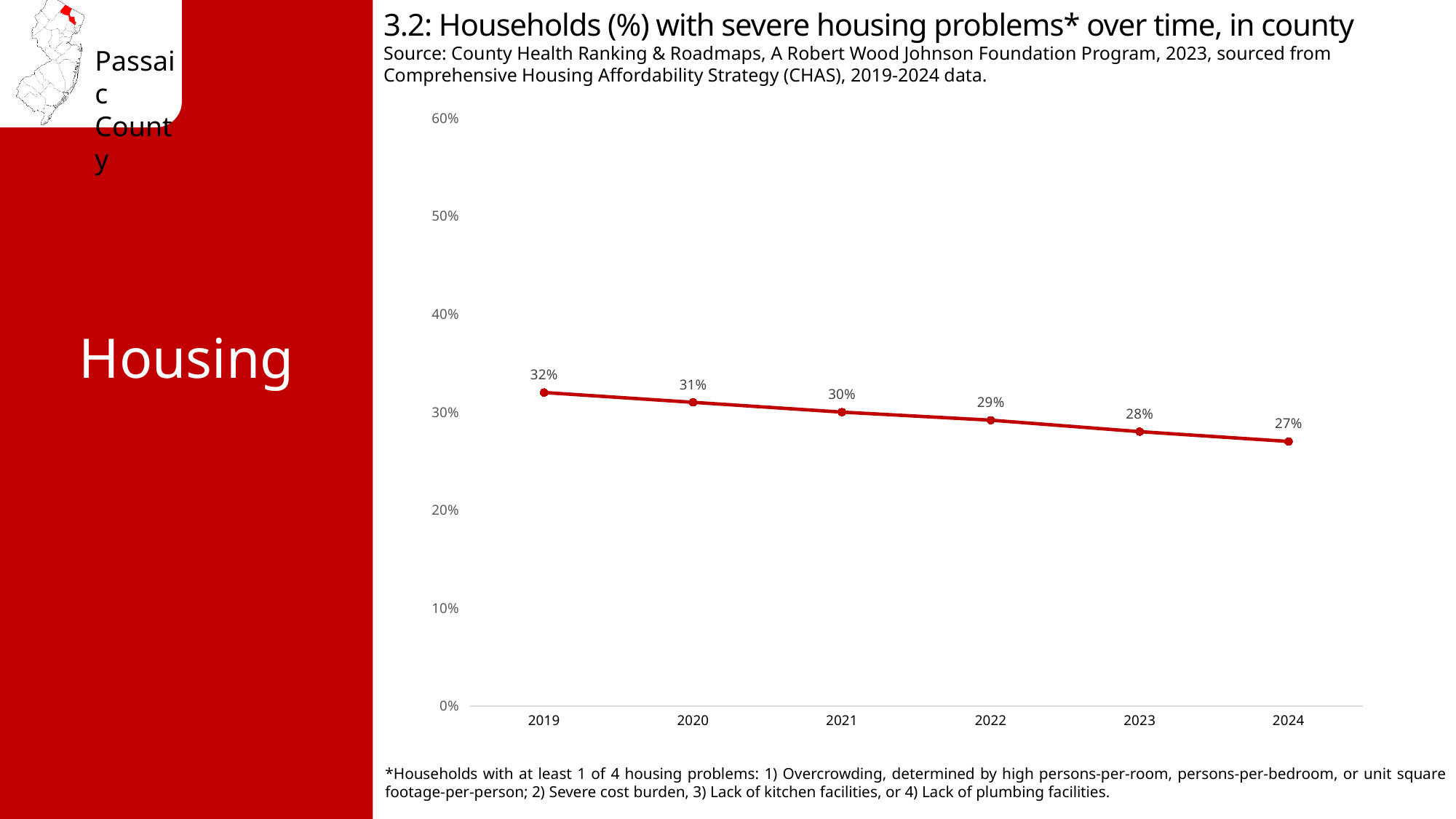
Which year has the lowest percentage of households with severe housing problems? 2024 What is the title of the chart? 3.2: Households (%) with severe housing problems* over time, in county Is the value for 2021 greater or less than 40%? less What is the difference between the 2019 value and the 2024 value? 5% What is the value shown for 2022? 29% Do the values rise or fall from 2019 to 2024? fall What kind of chart is shown on the slide? line chart Which year has a higher value, 2020 or 2023? 2020 How many years are plotted on the chart? 6 Which year has the highest percentage of households with severe housing problems? 2019 What percentage of households had severe housing problems in 2019? 32% What percentage of households had severe housing problems in 2024? 27%